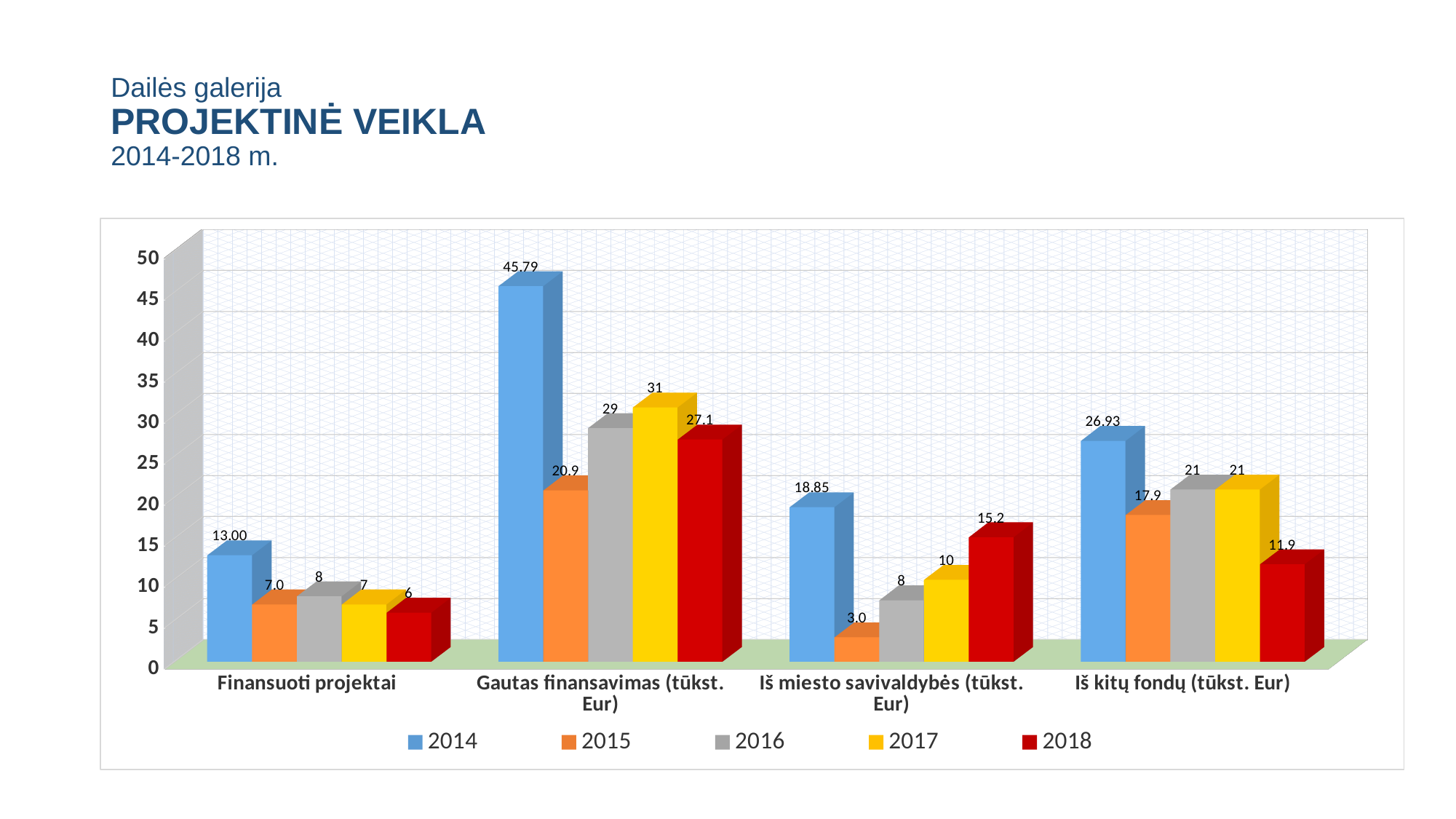
Which year has the lowest value in the 'Iš miesto savivaldybės (tūkst. Eur)' category? 2015 Is the value for 2018 in the 'Gautas finansavimas (tūkst. Eur)' category greater or less than 25? greater What kind of chart is shown on the slide? Bar chart Which year has the highest value in the 'Gautas finansavimas (tūkst. Eur)' category? 2014 What is the value for 2018 in the 'Iš miesto savivaldybės (tūkst. Eur)' category? 15.2 What is the value for 2014 in the 'Gautas finansavimas (tūkst. Eur)' category? 45.79 How many categories are shown on the x axis? 4 What is the value for 2015 in the 'Finansuoti projektai' category? 7.0 In the 'Iš kitų fondų (tūkst. Eur)' category, which is larger: the value for 2014 or the value for 2018? 2014 What is the value for 2016 in the 'Iš kitų fondų (tūkst. Eur)' category? 21 How many series does the legend list? 5 What is the difference between the 2017 and 2015 values in the 'Gautas finansavimas (tūkst. Eur)' category? 10.1